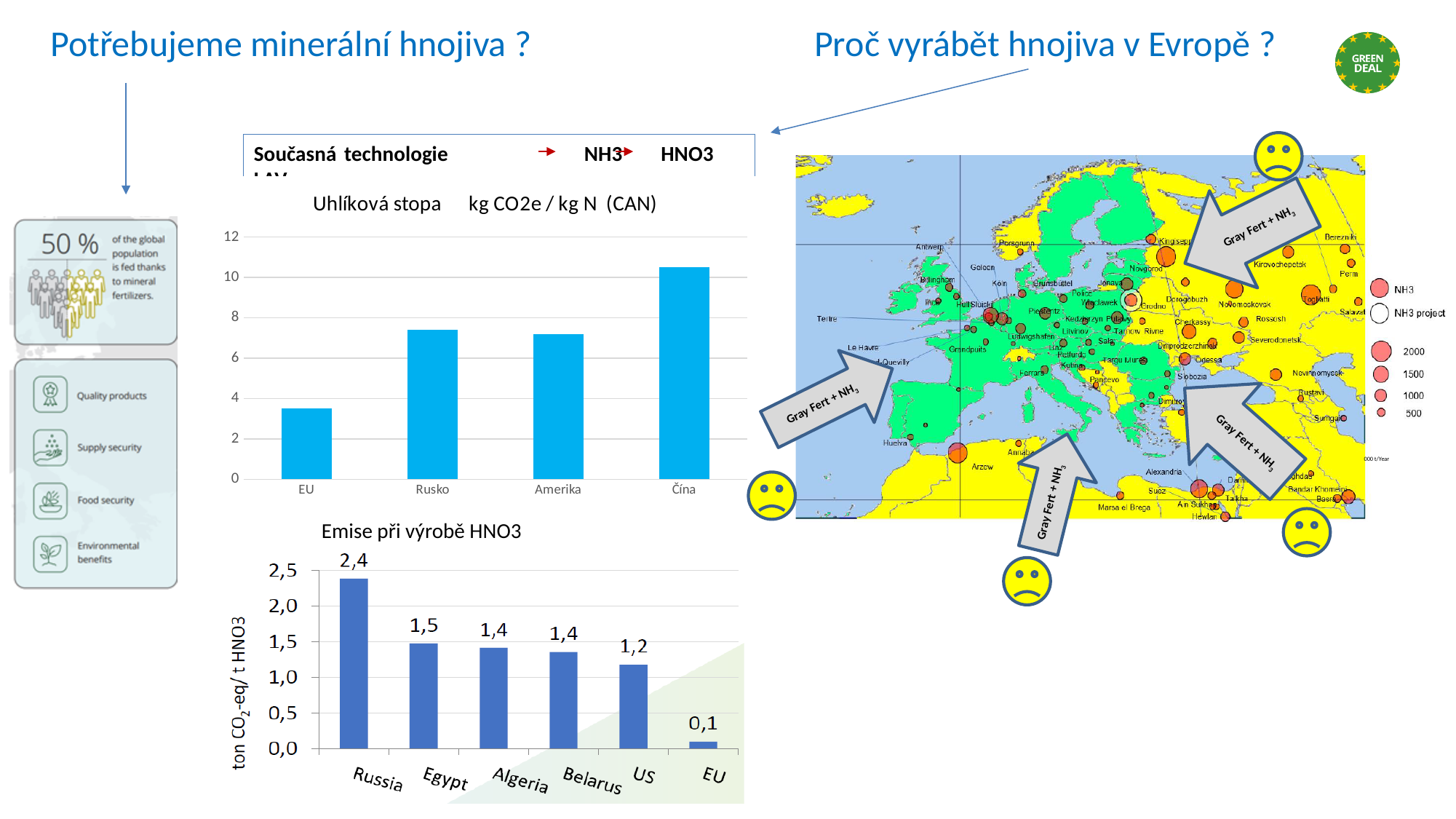
In the 'Emise při výrobě HNO3' chart, do the values rise or fall from left to right along the x axis? fall In the 'Emise při výrobě HNO3' chart, what is the value for US? 1,2 In the 'Uhlíková stopa' chart, how many categories are shown on the x axis? 4 In the 'Uhlíková stopa' chart, which category has the highest value? Čína What kind of chart is the 'Uhlíková stopa' chart? bar chart In the 'Emise při výrobě HNO3' chart, what is the value for Russia? 2,4 In the 'Emise při výrobě HNO3' chart, which is larger, the value for Egypt or the value for US? Egypt In the 'Uhlíková stopa' chart, which category has the lowest value? EU In the 'Uhlíková stopa' chart, is the value for Čína greater or less than 10? greater In the 'Uhlíková stopa' chart, is the value for EU greater or less than 4? less In the 'Emise při výrobě HNO3' chart, what is the difference between the values for Russia and Egypt? 0,9 In the 'Emise při výrobě HNO3' chart, what is the value for EU? 0,1